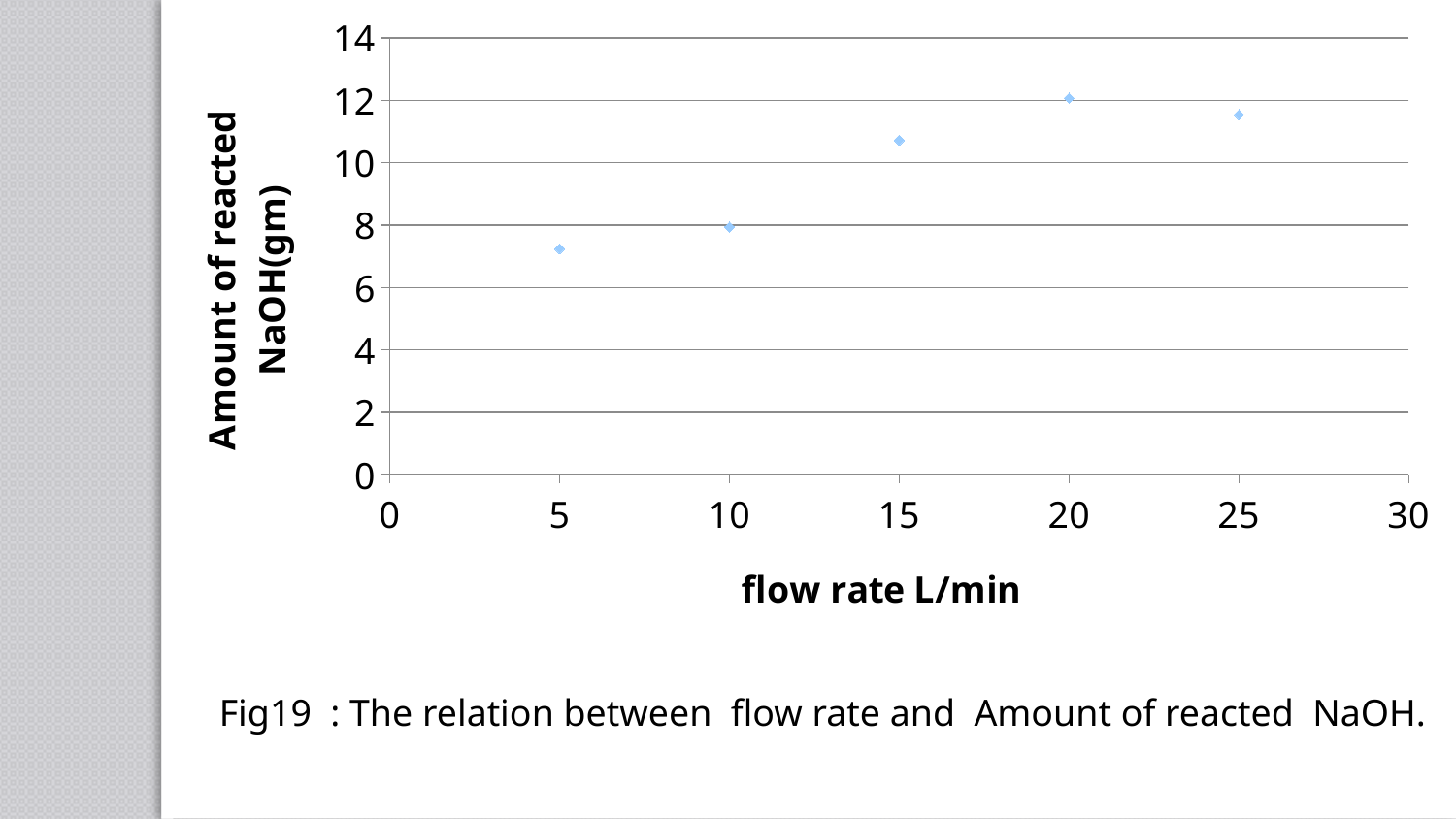
At which flow rate is the amount of reacted NaOH lowest? 5 L/min What is the label of the y axis? Amount of reacted NaOH(gm) What is the label of the x axis? flow rate L/min Which has a larger amount of reacted NaOH: a flow rate of 20 L/min or 25 L/min? 20 L/min Is the amount of reacted NaOH at a flow rate of 15 L/min greater or less than 10? greater Is the amount of reacted NaOH at a flow rate of 20 L/min greater or less than 10? greater Is the amount of reacted NaOH at a flow rate of 25 L/min greater or less than 12? less Which has a larger amount of reacted NaOH: a flow rate of 15 L/min or 5 L/min? 15 L/min What kind of chart is shown on the slide? scatter chart How many data points are plotted on the chart? 5 At which flow rate is the amount of reacted NaOH highest? 20 L/min